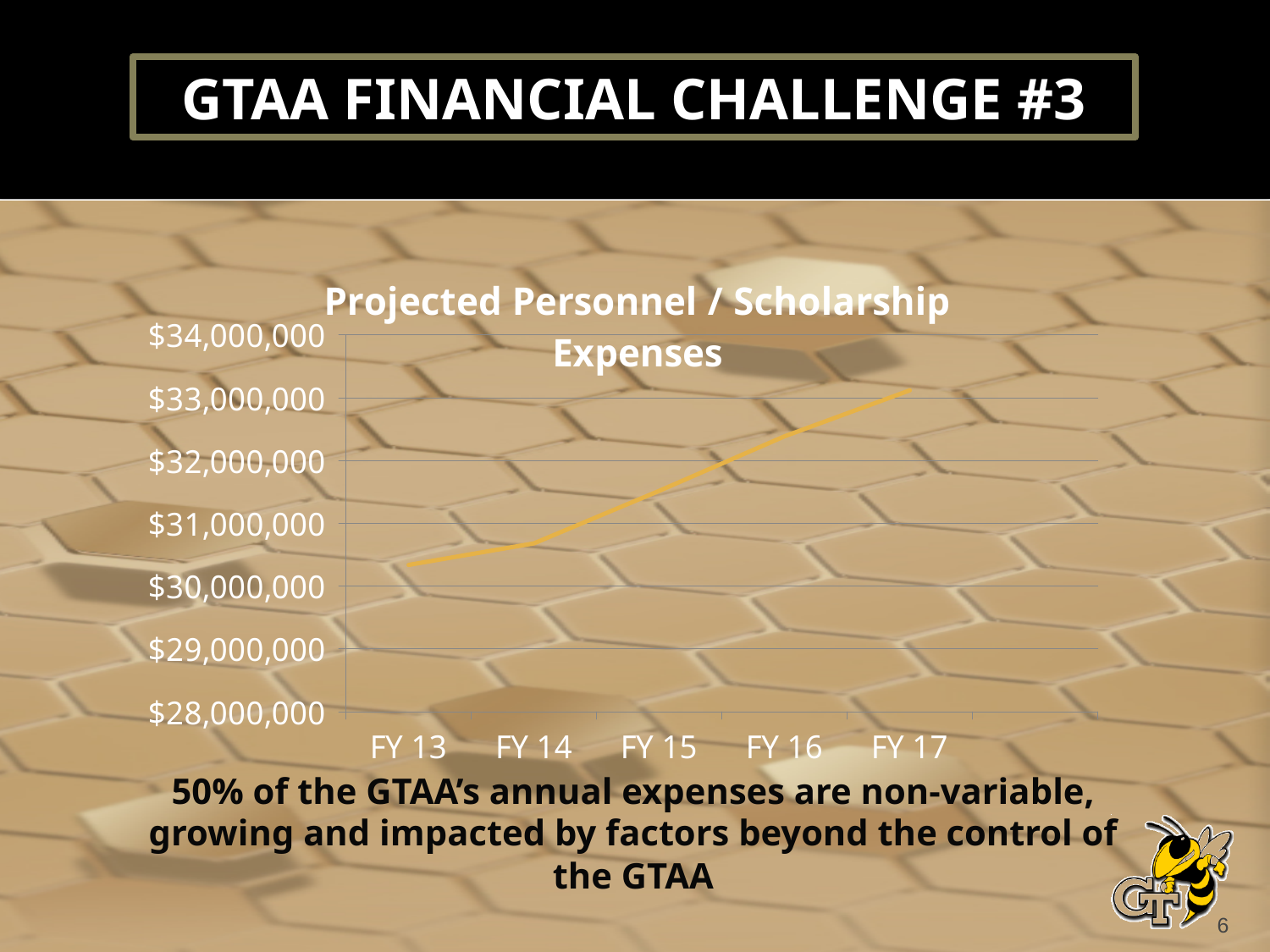
What kind of chart is shown on the slide? Line chart Is the value for FY 17 greater or less than $34,000,000? less What is the title of the chart? Projected Personnel / Scholarship Expenses Do the projected expenses rise or fall from FY 13 to FY 17? Rise Which is larger, the value for FY 16 or the value for FY 14? FY 16 Is the value for FY 16 greater or less than $32,000,000? greater Is the value for FY 15 greater or less than $31,000,000? greater Which fiscal year has the highest projected expenses? FY 17 How many fiscal years are plotted on the x axis of the chart? 5 Which fiscal year has the lowest projected expenses? FY 13